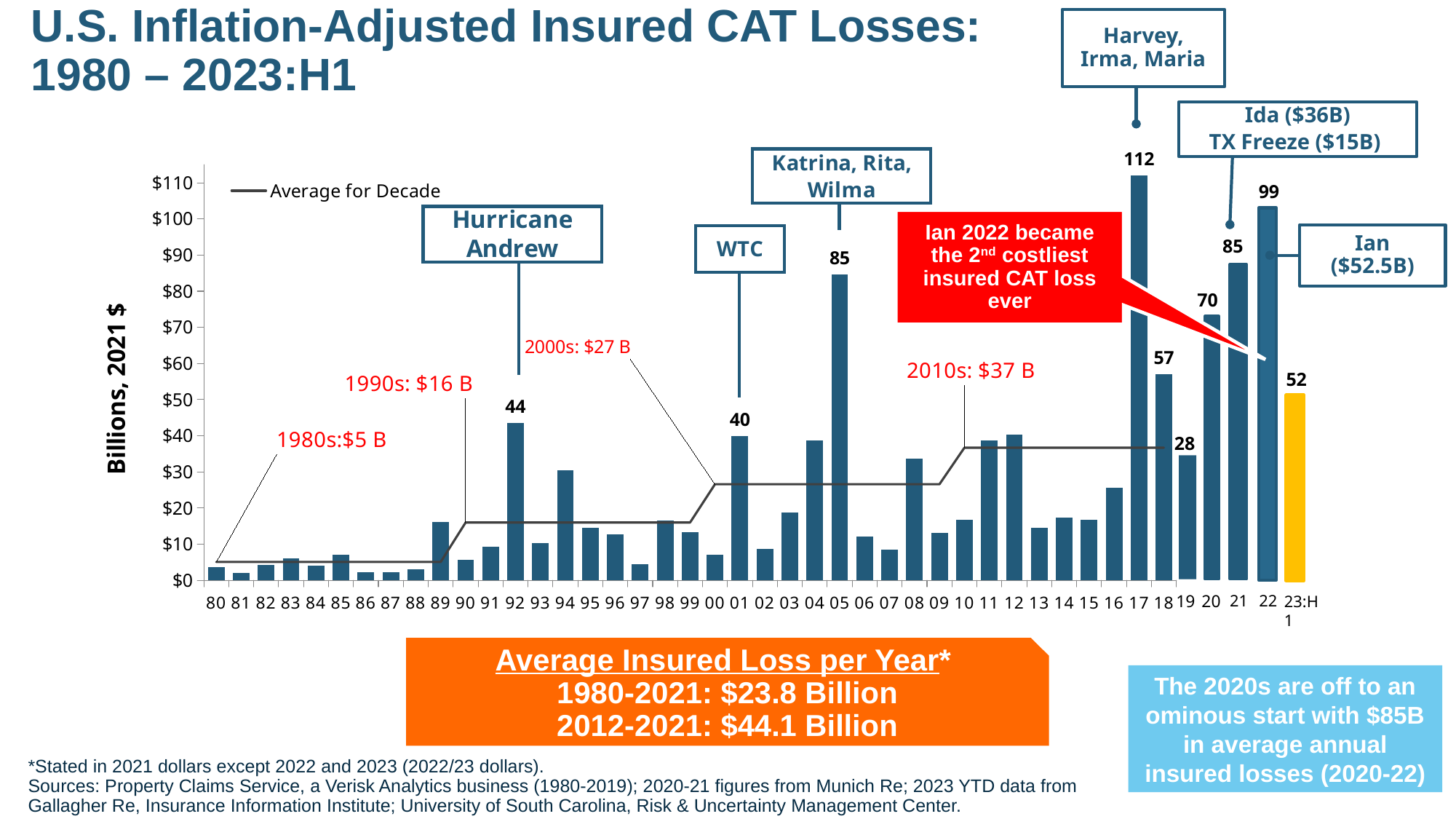
What is the value labeled for 2019? 28 Is the value for 2010 greater or less than $20? less What is the insured CAT loss value labeled for 2005? 85 What is the insured CAT loss value labeled for 2017? 112 What is the difference between the labeled values for 2022 and 2021? 14 Which year has the larger insured CAT loss, 2020 or 2018? 2020 Is the value for 1994 greater or less than $20? greater What is the average for the 1990s decade shown on the chart? $16 B What kind of chart is shown on the slide? combination bar and line chart What is the value labeled for 23:H1? 52 What is the difference between the labeled values for 2017 and 2005? 27 Which year has the highest insured CAT loss on the chart? 2017